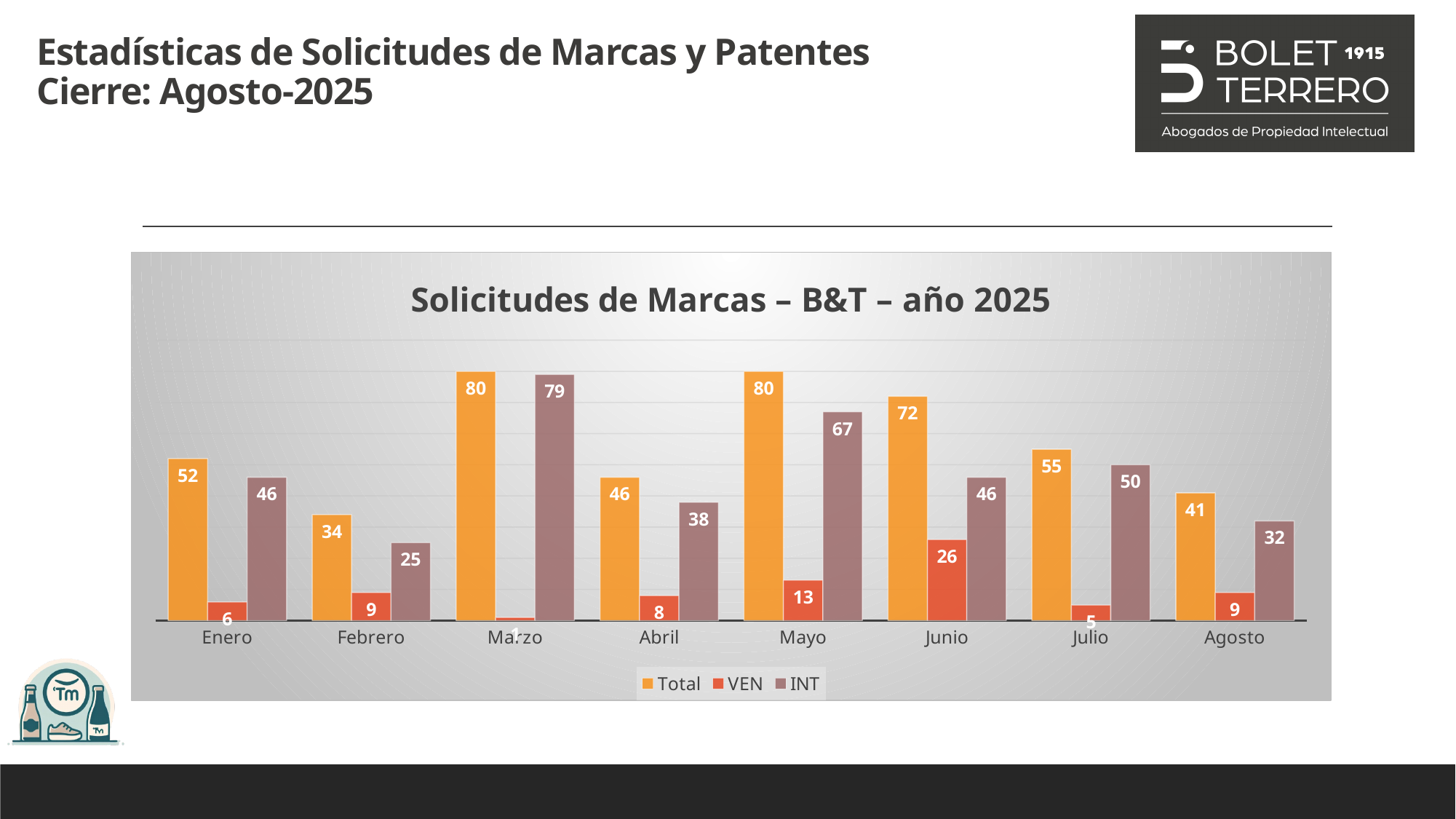
Which month has the lowest INT value? Febrero Which month has the highest VEN value? Junio What is the INT value for Mayo? 67 What is the title of the chart? Solicitudes de Marcas – B&T – año 2025 Which is larger, the INT value for Enero or the INT value for Abril? Enero What is the Total value for Junio? 72 What is the difference between the Total values for Julio and Agosto? 14 How many series does the legend list? 3 Which month has the highest INT value? Marzo How many months are shown on the x axis? 8 What type of chart is shown on the slide? bar chart What is the VEN value for Febrero? 9